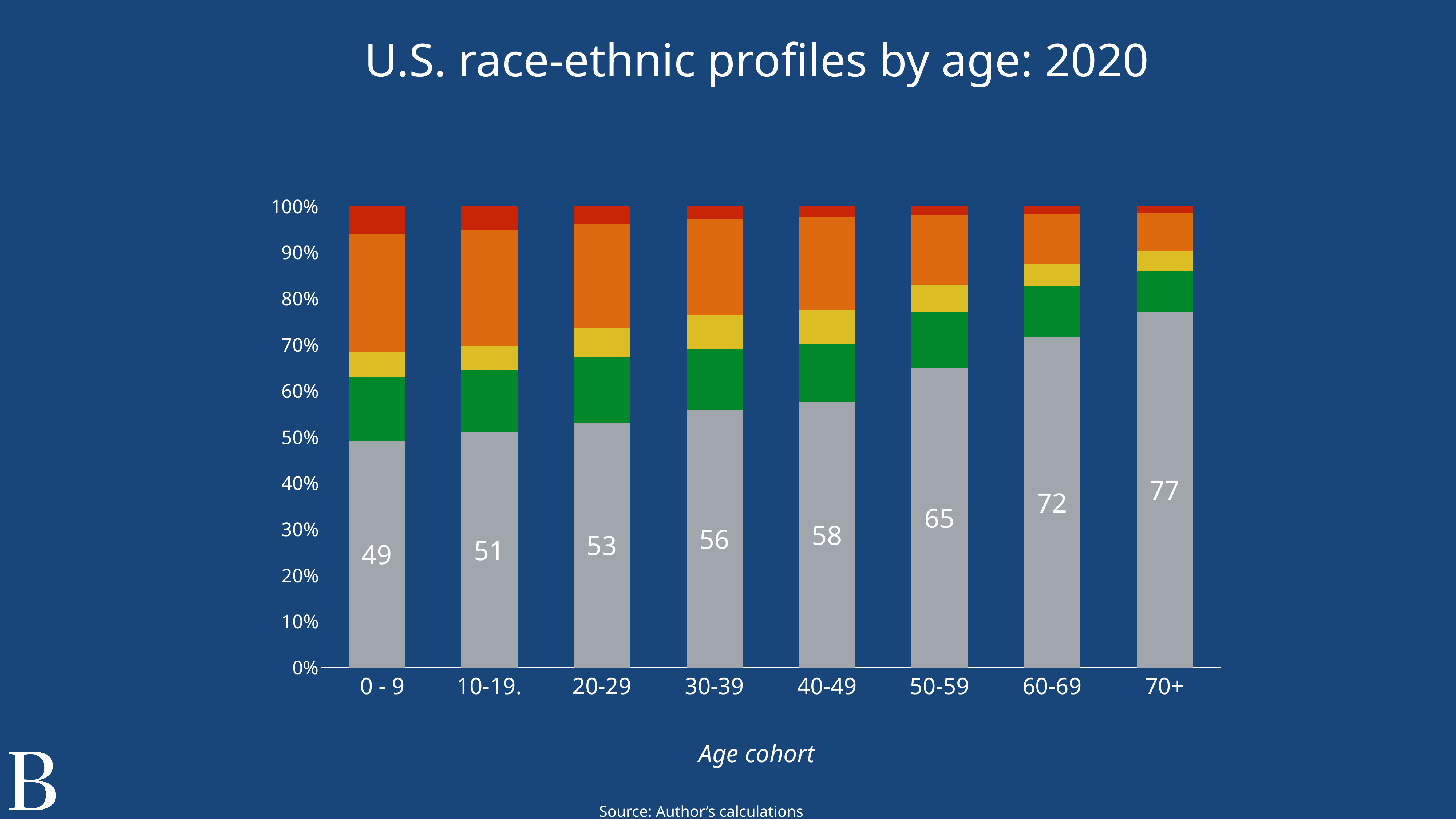
Which age cohort has the highest labelled value for the bottom (gray) segment? 70+ What is the difference between the labelled gray-segment values for the 70+ and 0 - 9 age cohorts? 28 What is the labelled value of the bottom (gray) segment for the 0 - 9 age cohort? 49 What type of chart is shown on the slide? stacked bar chart Which age cohort has the lowest labelled value for the bottom (gray) segment? 0 - 9 What is the title of the chart? U.S. race-ethnic profiles by age: 2020 Do the labelled gray-segment values rise or fall as the age cohorts move from 0 - 9 to 70+? rise How many age cohorts are shown on the x axis? 8 What is the labelled value of the bottom (gray) segment for the 40-49 age cohort? 58 Which has a larger labelled gray-segment value, the 50-59 cohort or the 30-39 cohort? 50-59 What is the label of the x axis? Age cohort What is the labelled value of the bottom (gray) segment for the 70+ age cohort? 77